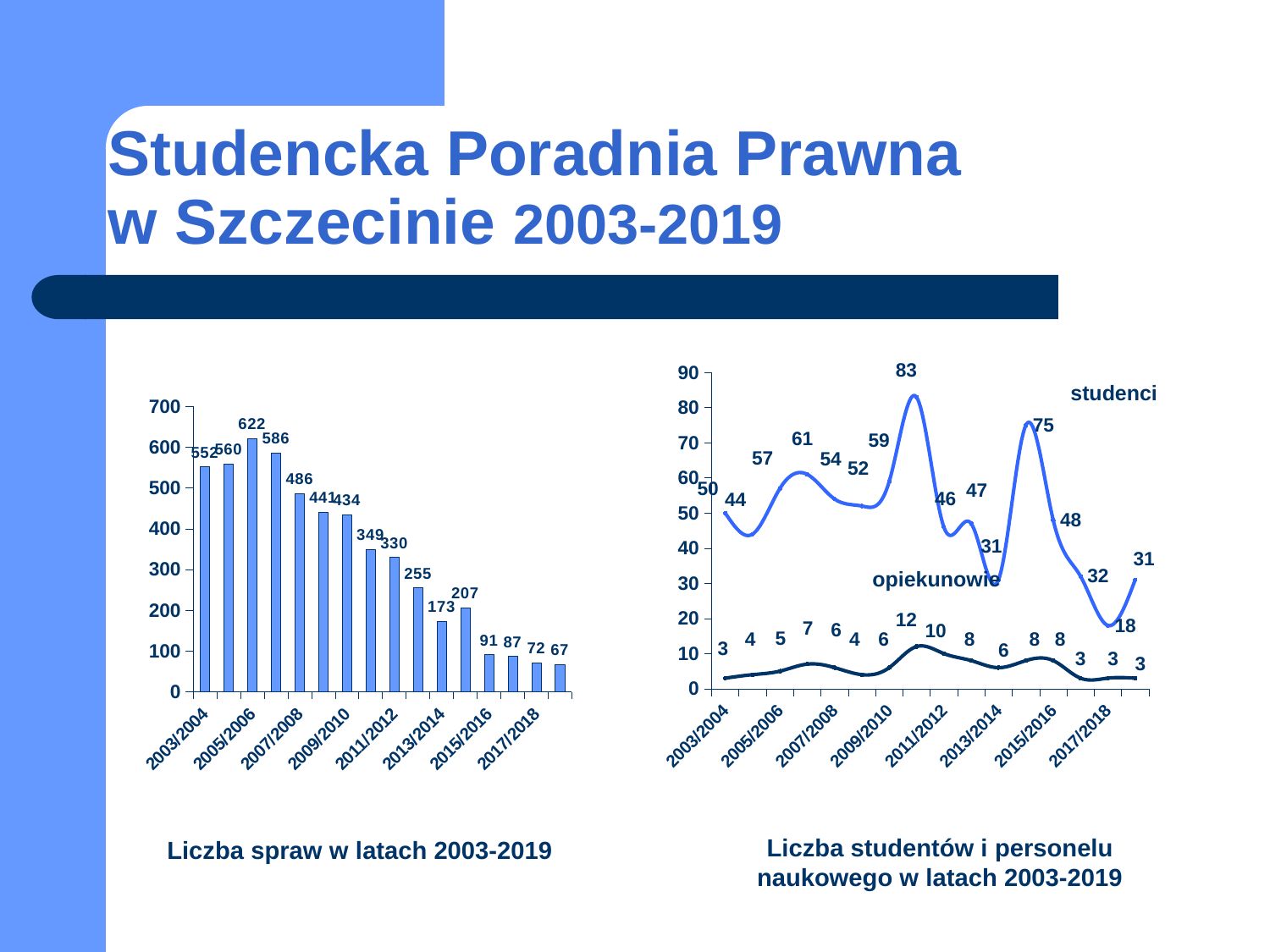
In the chart 'Liczba spraw w latach 2003-2019', what is the value for 2003/2004? 552 In the chart 'Liczba spraw w latach 2003-2019', what is the value of the last bar (2018/2019)? 67 In the chart 'Liczba spraw w latach 2003-2019', which year has the highest number of cases? 2005/2006 In the chart 'Liczba studentów i personelu naukowego w latach 2003-2019', what is the value of 'studenci' for 2003/2004? 50 In the chart 'Liczba spraw w latach 2003-2019', what is the difference between the values for 2005/2006 and 2007/2008? 136 In the chart 'Liczba studentów i personelu naukowego w latach 2003-2019', what is the highest value of the 'opiekunowie' series? 12 What kind of chart is 'Liczba spraw w latach 2003-2019'? bar chart In the chart 'Liczba spraw w latach 2003-2019', do the values generally rise or fall from 2005/2006 onward? fall In the chart 'Liczba spraw w latach 2003-2019', what is the value for 2005/2006? 622 In the chart 'Liczba studentów i personelu naukowego w latach 2003-2019', what is the highest value of the 'studenci' series? 83 In the chart 'Liczba studentów i personelu naukowego w latach 2003-2019', what is the value of 'opiekunowie' for 2017/2018? 3 How many series are plotted in the chart 'Liczba studentów i personelu naukowego w latach 2003-2019'? 2